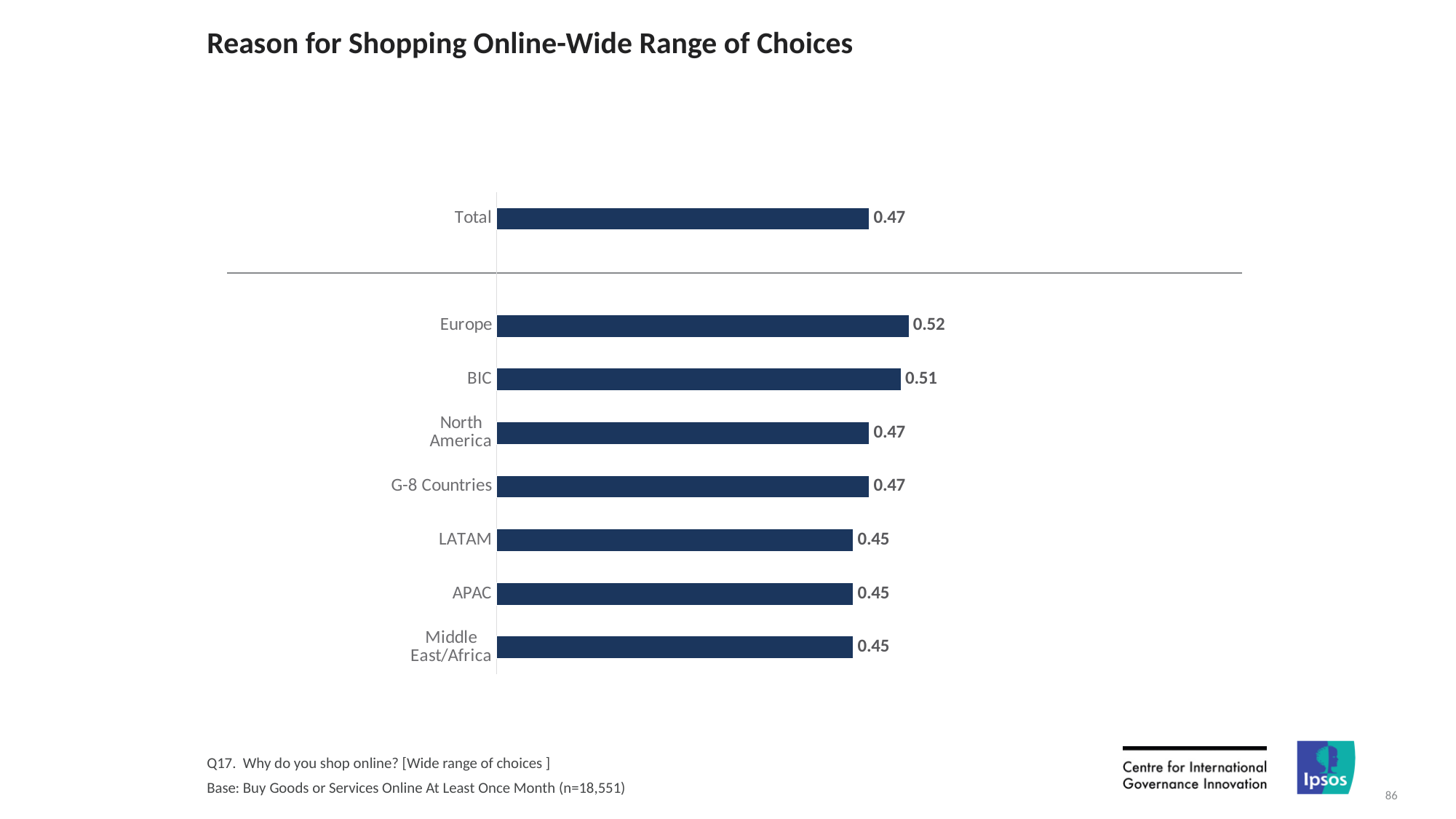
What is the value for BIC? 0.51 What is the value for Middle East/Africa? 0.45 What is the value for Total? 0.47 How many bars are shown in the chart? 8 What is the value for Europe? 0.52 What is the difference between the values for BIC and North America? 0.04 What kind of chart is shown on the slide? Bar chart Which region has the highest value? Europe Which is larger, the value for Europe or the value for APAC? Europe What is the value for LATAM? 0.45 What is the title of the chart? Reason for Shopping Online-Wide Range of Choices What is the difference between the values for Europe and LATAM? 0.07